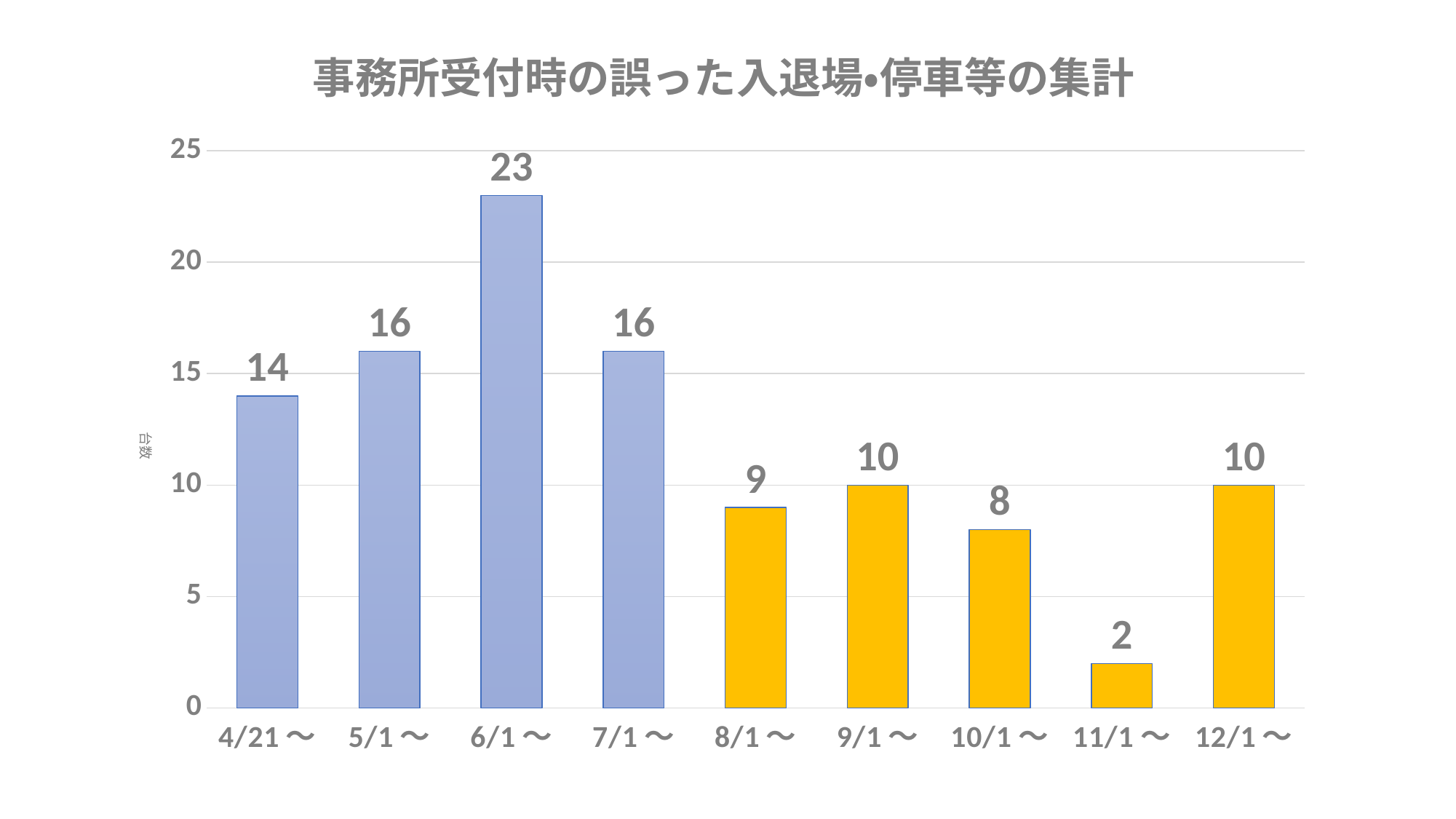
Which is larger, the value for 8/1～ or the value for 10/1～? 8/1～ What is the value for 4/21～? 14 Which category has the lowest value? 11/1～ What kind of chart is shown on the slide? bar chart How many categories are shown on the x axis? 9 What is the difference between the values for 6/1～ and 7/1～? 7 What is the value for 6/1～? 23 Which category has the highest value? 6/1～ What is the value for 11/1～? 2 What is the title of the chart? 事務所受付時の誤った入退場•停車等の集計 Is the value for 5/1～ greater or less than 15? greater What is the label on the vertical axis? 台数